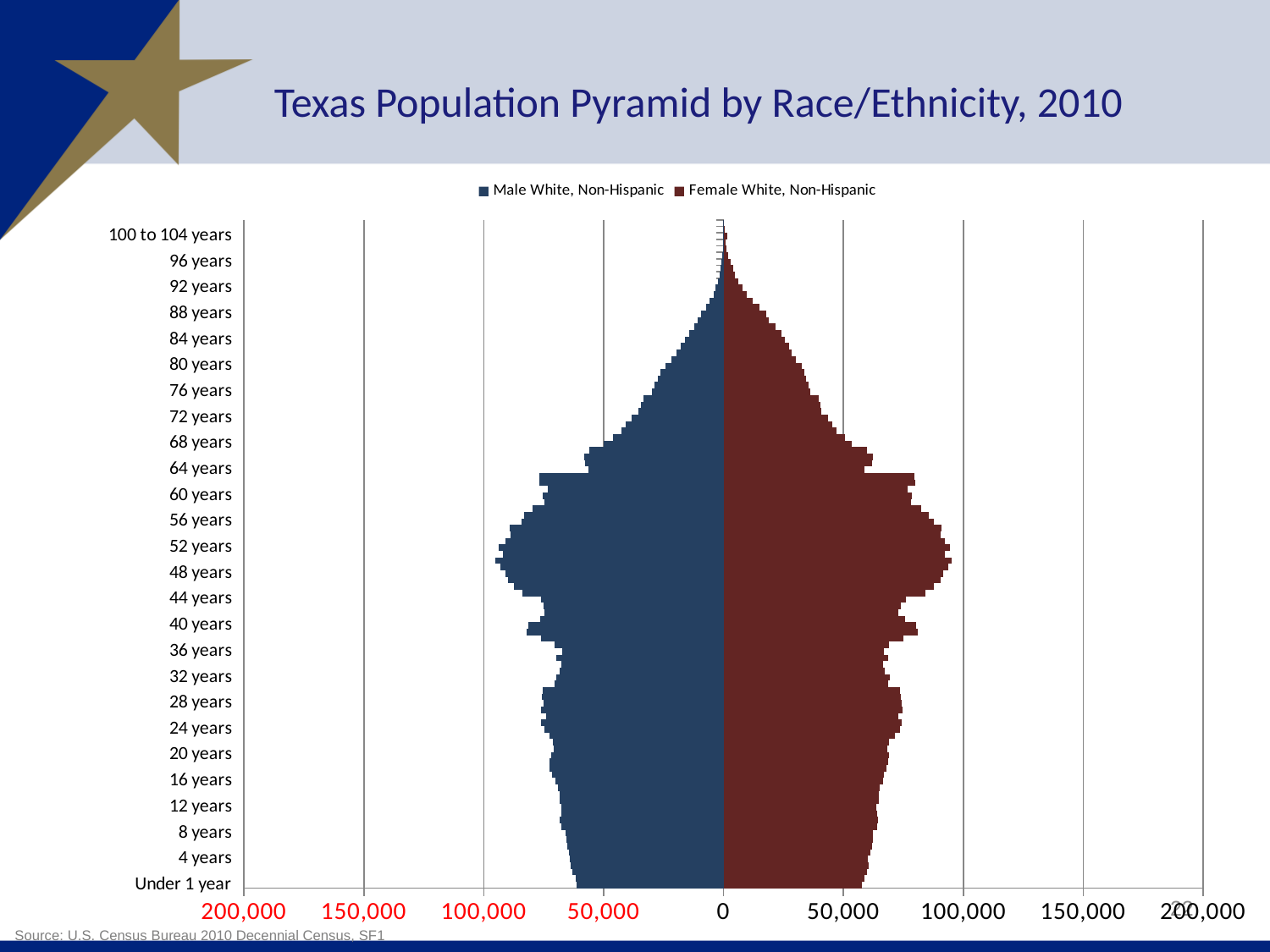
What kind of chart is shown on the slide? Bar chart What is the title of the chart? Texas Population Pyramid by Race/Ethnicity, 2010 Do the Female White, Non-Hispanic values rise or fall from 60 years up to 100 to 104 years? fall Which is larger for Male White, Non-Hispanic: the value at 24 years or the value at 88 years? 24 years Which two series are listed in the legend? Male White, Non-Hispanic and Female White, Non-Hispanic Is the value for Female White, Non-Hispanic at 52 years greater or less than 50,000? greater How many series does the legend list? 2 Is the value for Male White, Non-Hispanic at Under 1 year greater or less than 50,000? greater Is the value for Female White, Non-Hispanic at 100 to 104 years greater or less than 50,000? less Which is larger for Female White, Non-Hispanic: the value at 52 years or the value at 80 years? 52 years